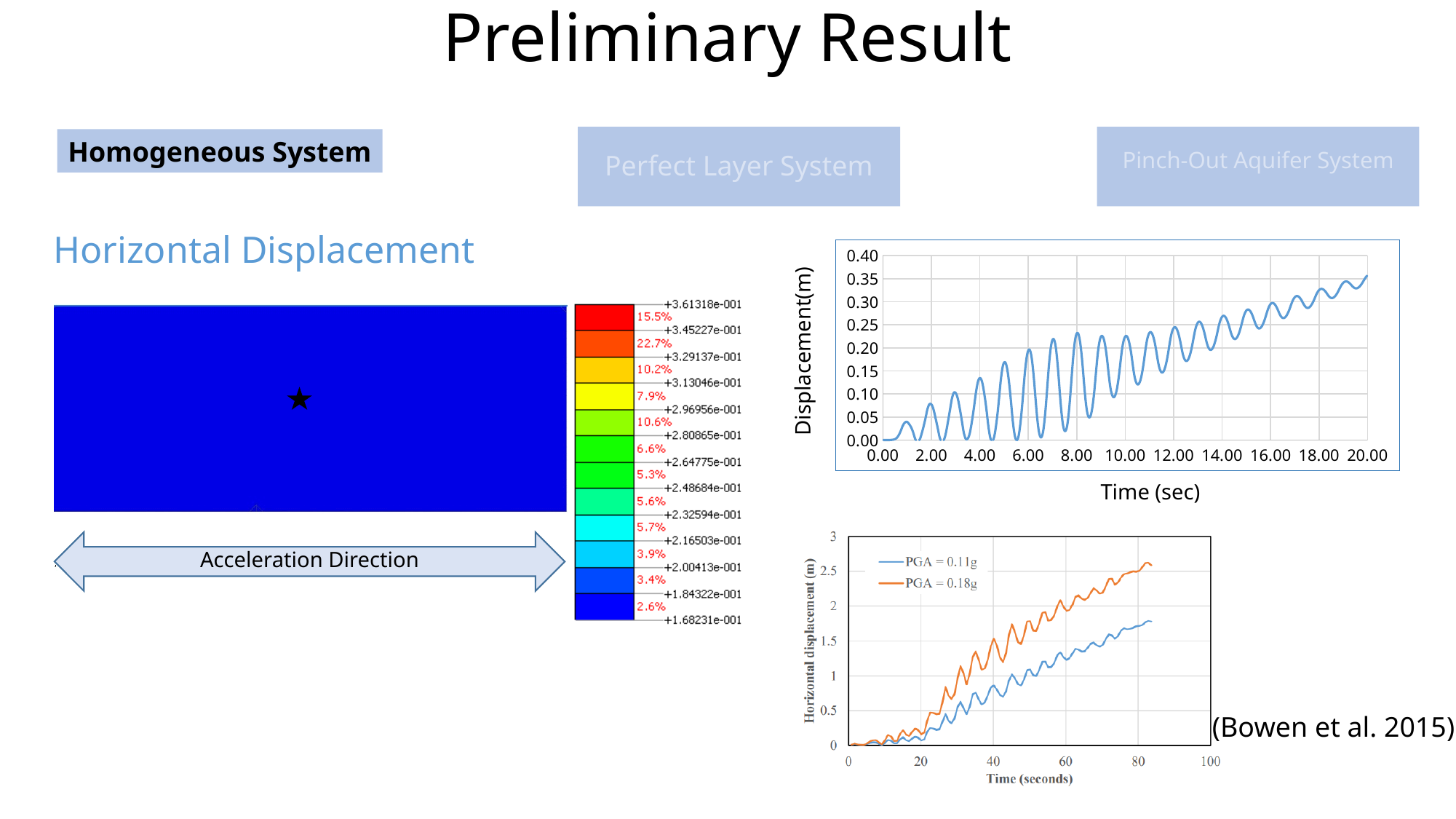
What kind of chart is the lower chart (Bowen et al. 2015)? line chart In the upper chart (Displacement(m) vs Time (sec)), do the displacement values generally rise or fall as time increases? rise In the lower chart (Bowen et al. 2015), is the horizontal displacement for PGA = 0.18g at 80 seconds greater or less than 2? greater What are the two legend entries in the lower chart (Bowen et al. 2015)? PGA = 0.11g and PGA = 0.18g In the lower chart (Bowen et al. 2015), which series reaches the higher horizontal displacement at around 80 seconds, PGA = 0.11g or PGA = 0.18g? PGA = 0.18g In the lower chart (Bowen et al. 2015), do the horizontal displacement values rise or fall as time increases? rise In the upper chart (Displacement(m) vs Time (sec)), is the displacement at 20.00 sec greater or less than 0.30? greater What kind of chart is the upper chart on the right, with Displacement(m) on the y axis? line chart In the upper chart (Displacement(m) vs Time (sec)), is the displacement at 10.00 sec greater or less than 0.30? less How many series does the legend of the lower chart (Bowen et al. 2015) list? 2 In the upper chart (Displacement(m) vs Time (sec)), what is the highest value shown on the y axis? 0.40